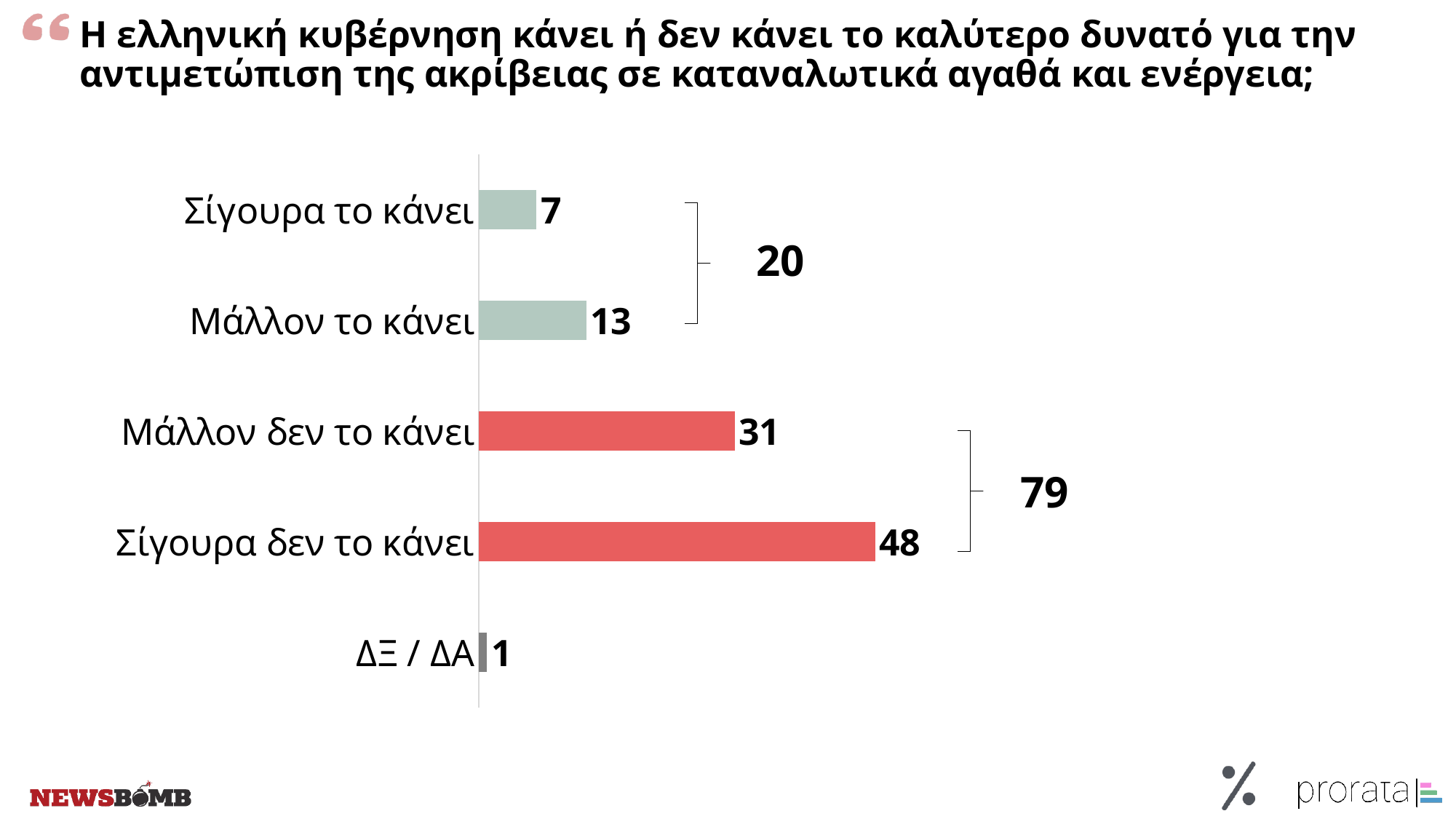
What is the value for "Σίγουρα δεν το κάνει"? 48 Which category has the lowest value? ΔΞ / ΔΑ What combined total is shown by the bracket grouping "Μάλλον δεν το κάνει" and "Σίγουρα δεν το κάνει"? 79 What is the value for "ΔΞ / ΔΑ"? 1 What is the difference between the values for "Σίγουρα δεν το κάνει" and "Μάλλον δεν το κάνει"? 17 How many categories are shown in the chart? 5 What kind of chart is shown on the slide? Bar chart What is the value for "Μάλλον δεν το κάνει"? 31 Which category has the highest value? Σίγουρα δεν το κάνει What is the value for "Σίγουρα το κάνει"? 7 Which is larger, the value for "Μάλλον το κάνει" or the value for "Σίγουρα το κάνει"? Μάλλον το κάνει What is the value for "Μάλλον το κάνει"? 13